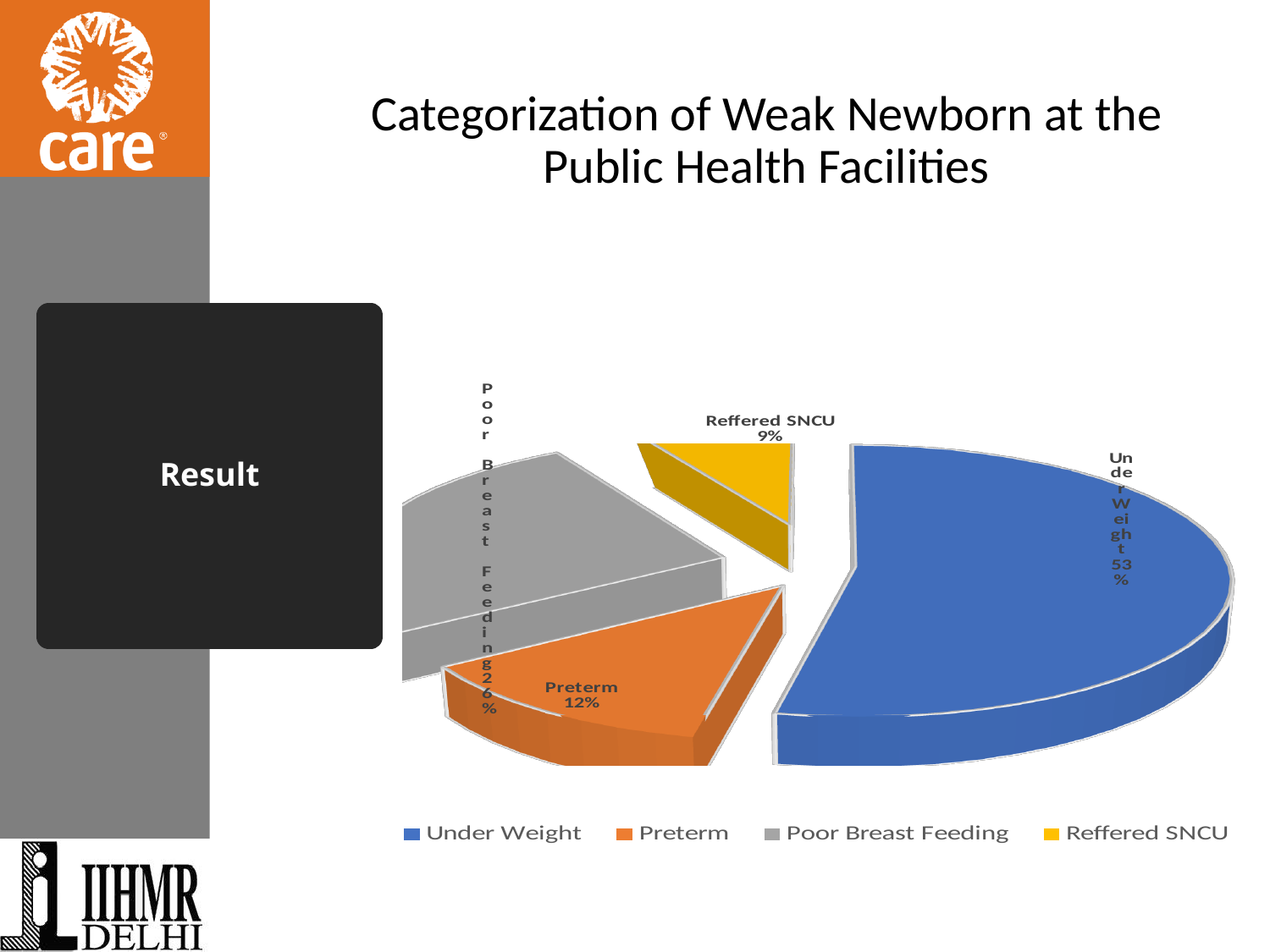
What is the difference in percentage points between Under Weight and Preterm? 41 What percentage of weak newborns are categorized as Preterm? 12% What is the difference in percentage points between Poor Breast Feeding and Reffered SNCU? 17 What percentage of weak newborns are categorized as Reffered SNCU? 9% Which category has the largest share of the pie? Under Weight Which is larger, the share for Poor Breast Feeding or the share for Preterm? Poor Breast Feeding How many categories does the pie chart show? 4 What kind of chart is shown on the slide? Pie chart What percentage of weak newborns are categorized as Poor Breast Feeding? 26% Which category has the smallest share of the pie? Reffered SNCU What colour is the Under Weight slice in the pie chart? Blue What percentage of weak newborns are categorized as Under Weight? 53%